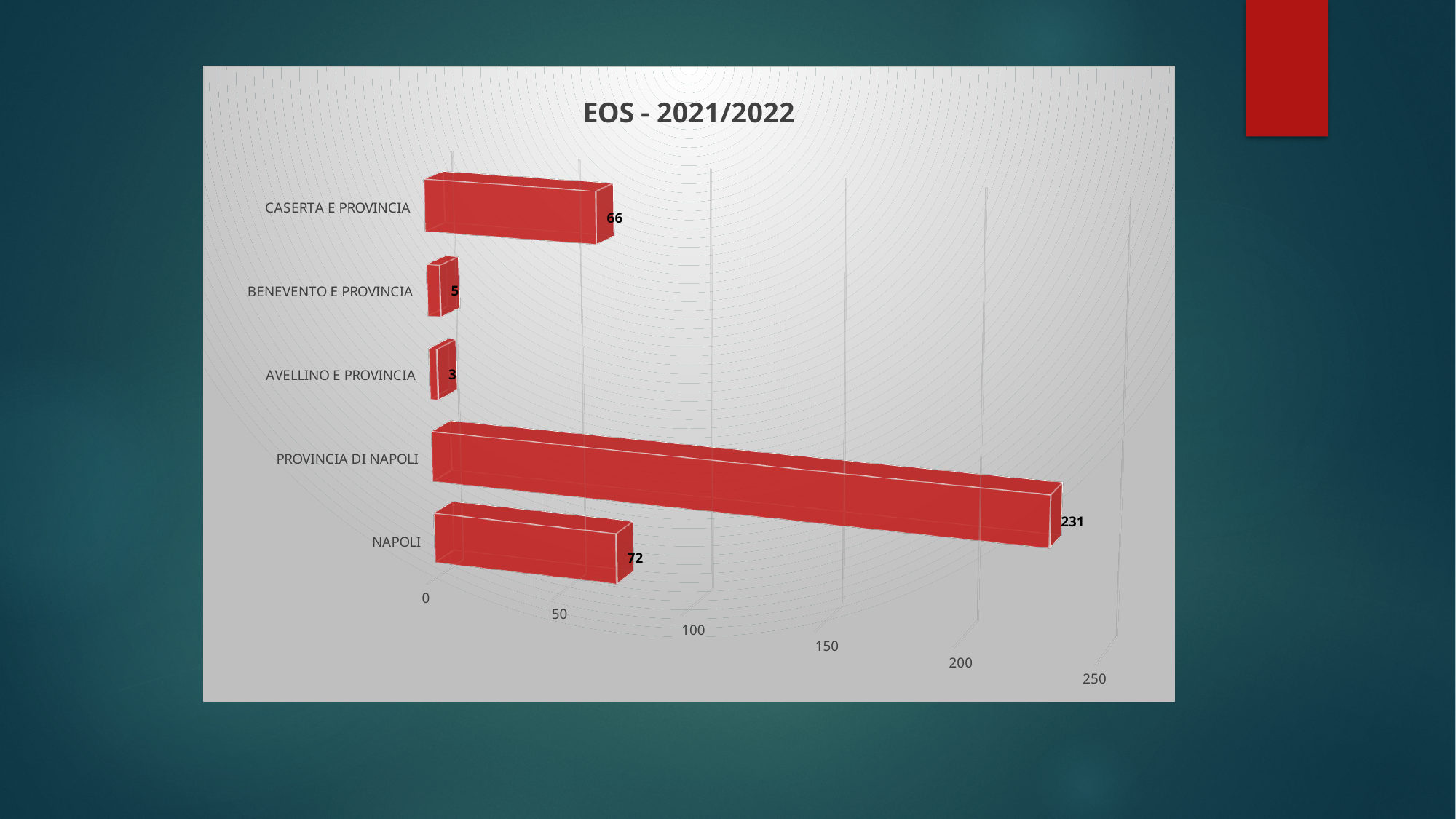
Which category has the lowest value? AVELLINO E PROVINCIA What kind of chart is shown on the slide? Bar chart Which is larger, the value for BENEVENTO E PROVINCIA or AVELLINO E PROVINCIA? BENEVENTO E PROVINCIA What is the value for BENEVENTO E PROVINCIA? 5 What is the difference between the values for NAPOLI and CASERTA E PROVINCIA? 6 What is the difference between the values for PROVINCIA DI NAPOLI and NAPOLI? 159 What is the value for NAPOLI? 72 What is the title of the chart? EOS - 2021/2022 How many categories are shown in the chart? 5 What is the value for CASERTA E PROVINCIA? 66 What is the value for PROVINCIA DI NAPOLI? 231 Which category has the highest value? PROVINCIA DI NAPOLI